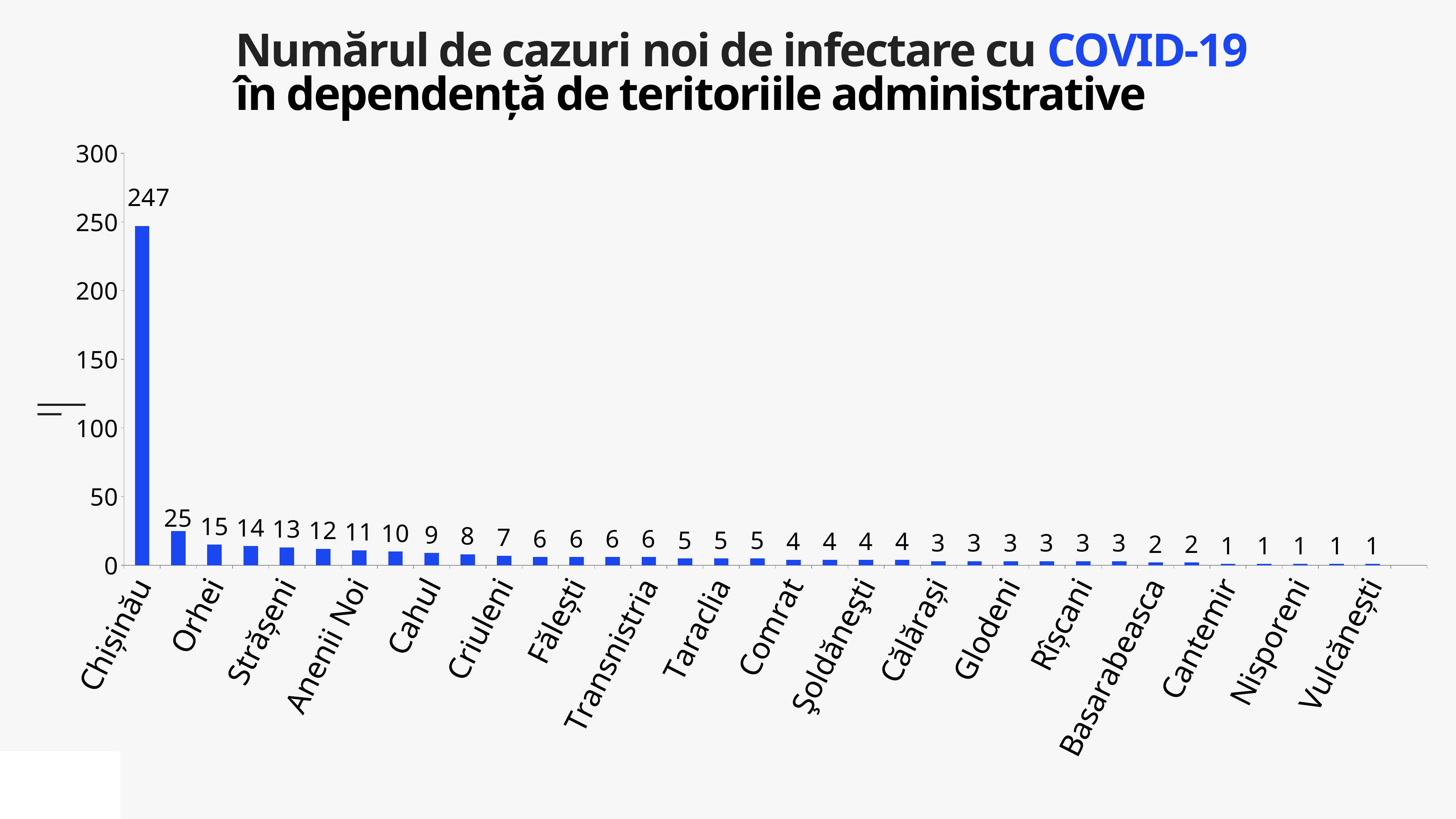
Do the values rise or fall from left to right along the x axis? Fall What is the value for Cantemir? 1 Is the value for Chișinău greater or less than 200? greater What is the highest value shown on the vertical axis? 300 What is the value for Taraclia? 5 What kind of chart is shown on the slide? Bar chart What is the difference between the values for Chișinău and Taraclia? 242 What is the value for Călărași? 3 Which territory has the highest number of new cases? Chișinău What is the value for Chișinău? 247 What is the value for Comrat? 4 Which is larger, the value for Chișinău or the value for Comrat? Chișinău